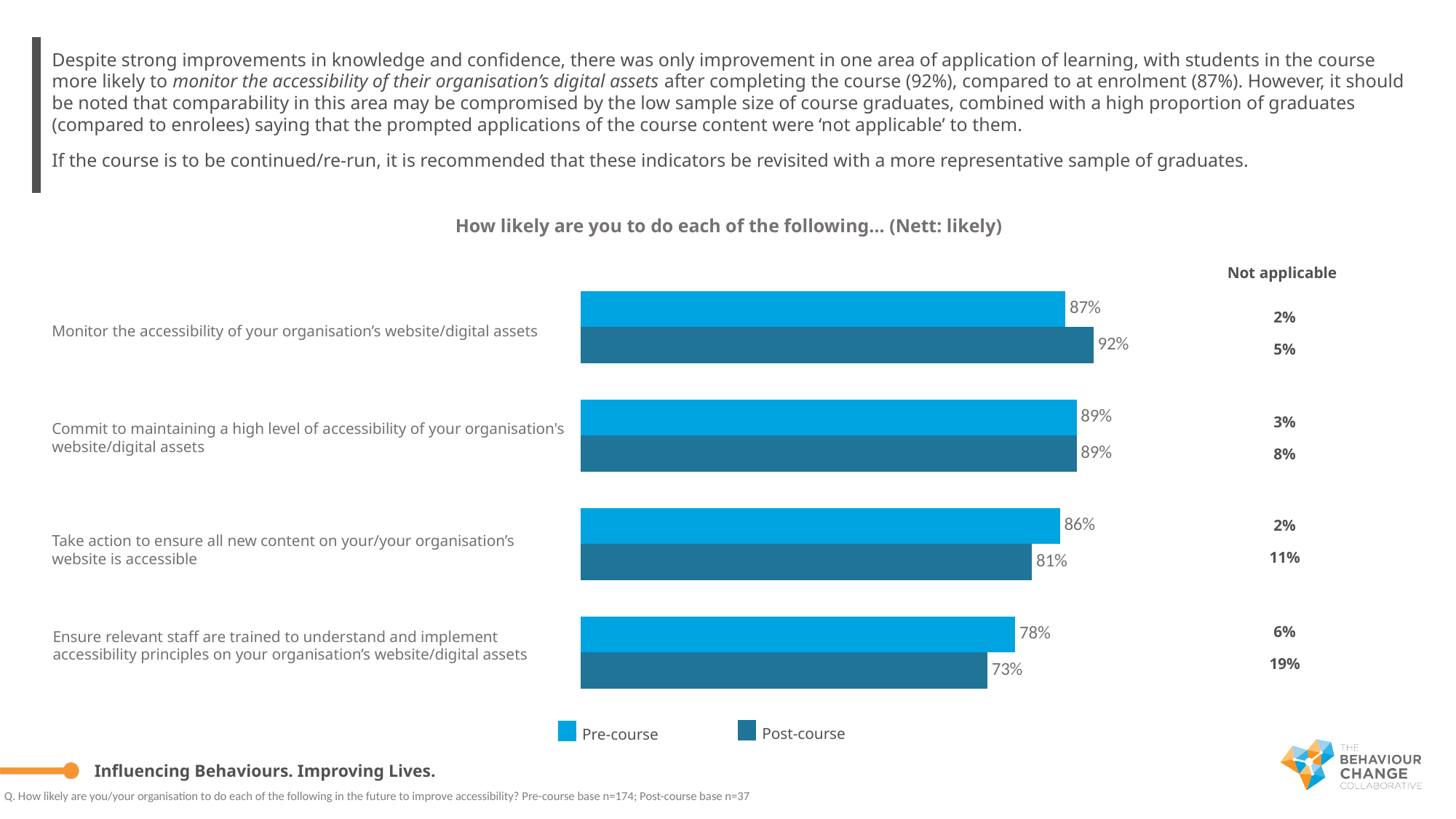
What is the Post-course value for 'Monitor the accessibility of your organisation's website/digital assets'? 92% What is the title of the chart? How likely are you to do each of the following… (Nett: likely) What is the 'Not applicable' percentage for Post-course respondents for 'Ensure relevant staff are trained to understand and implement accessibility principles on your organisation's website/digital assets'? 19% Which category has the lowest Post-course value? Ensure relevant staff are trained to understand and implement accessibility principles on your organisation's website/digital assets What is the Pre-course value for 'Ensure relevant staff are trained to understand and implement accessibility principles on your organisation's website/digital assets'? 78% What kind of chart is shown on the slide? Bar chart What is the Post-course value for 'Take action to ensure all new content on your/your organisation's website is accessible'? 81% Which category has the highest Pre-course value? Commit to maintaining a high level of accessibility of your organisation's website/digital assets How many series does the legend list? 2 What is the difference between the Post-course and Pre-course values for 'Monitor the accessibility of your organisation's website/digital assets'? 5% For 'Take action to ensure all new content on your/your organisation's website is accessible', which is larger: the Pre-course or Post-course value? Pre-course How many categories are shown in the chart? 4